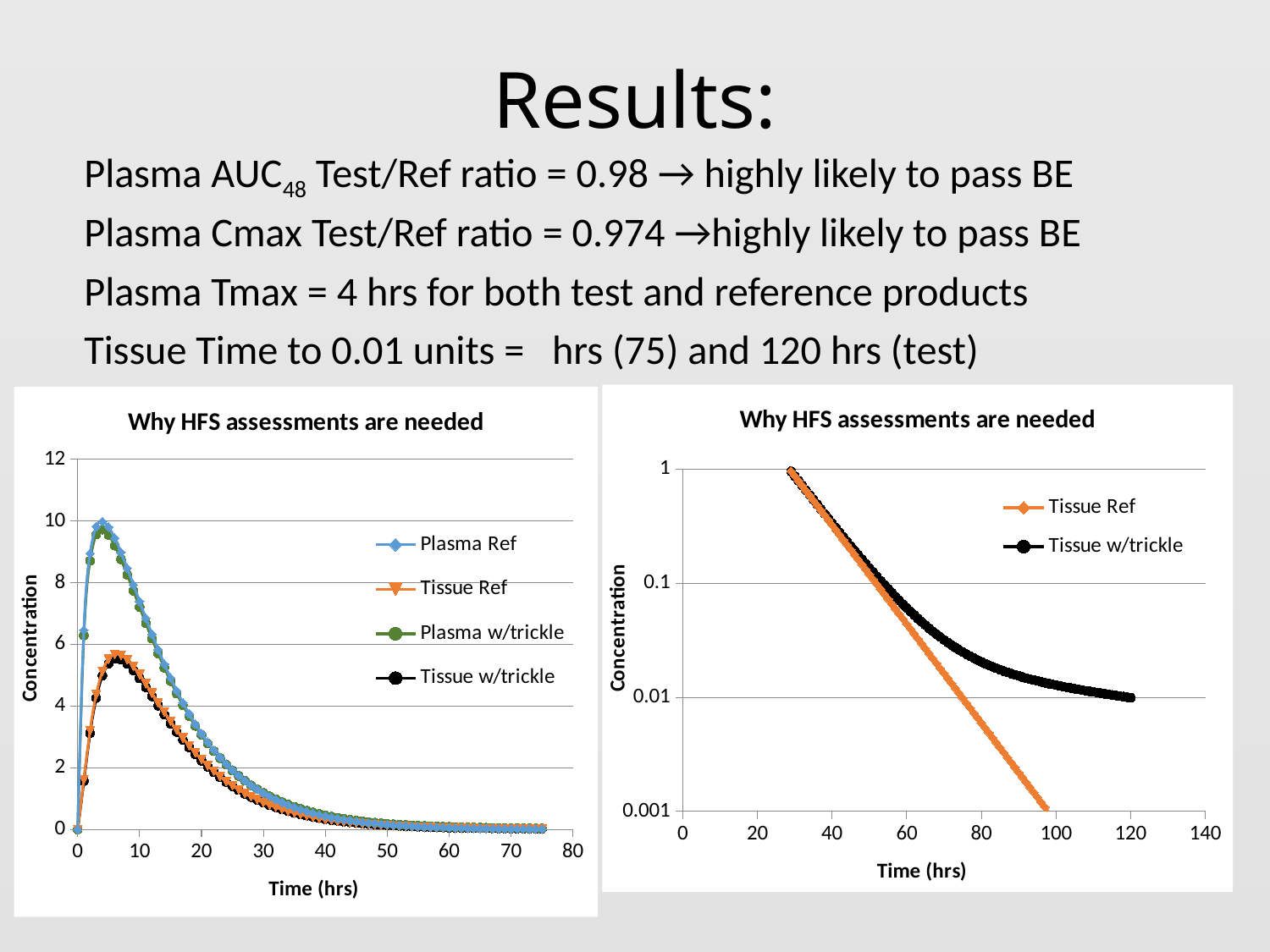
On the right chart, is the value of Tissue Ref at 80 hrs greater or less than 0.01? less What kind of chart is the left chart? line chart On the left chart, is the peak value of Tissue Ref greater or less than 4? greater On the right chart, do the values of Tissue Ref rise or fall as time increases? fall On the right chart, which series has the higher value at 80 hrs, Tissue Ref or Tissue w/trickle? Tissue w/trickle What kind of chart is the right chart? line chart On the left chart, is the peak value of Plasma Ref greater or less than 8? greater On the left chart, which series reaches a higher peak, Plasma Ref or Tissue Ref? Plasma Ref What is the title of the x axis on the right chart? Time (hrs) On the right chart, how many series does the legend list? 2 On the left chart, how many series does the legend list? 4